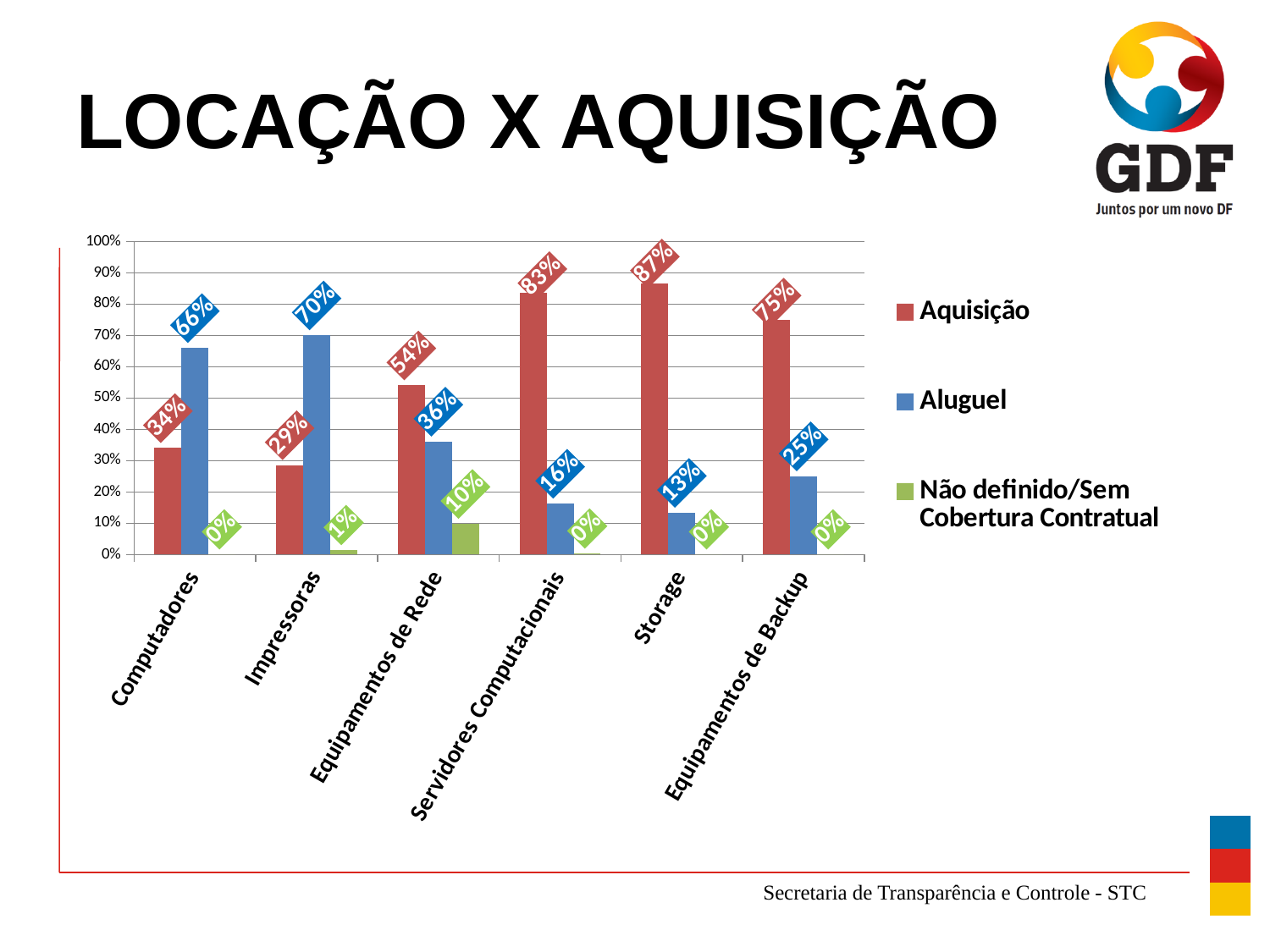
Which category has the highest Aquisição value? Storage How many categories are shown on the x axis? 6 What is the Não definido/Sem Cobertura Contratual value for Equipamentos de Rede? 10% How many series does the legend list? 3 What is the Aquisição value for Storage? 87% What kind of chart is shown on the slide? Bar chart What is the difference between the Aquisição and Aluguel values for Equipamentos de Backup? 50% What is the title of the slide containing the chart? LOCAÇÃO X AQUISIÇÃO Which category has the lowest Aquisição value? Impressoras What is the Aluguel value for Impressoras? 70% For Computadores, which is larger: Aquisição or Aluguel? Aluguel What is the Aluguel value for Servidores Computacionais? 16%